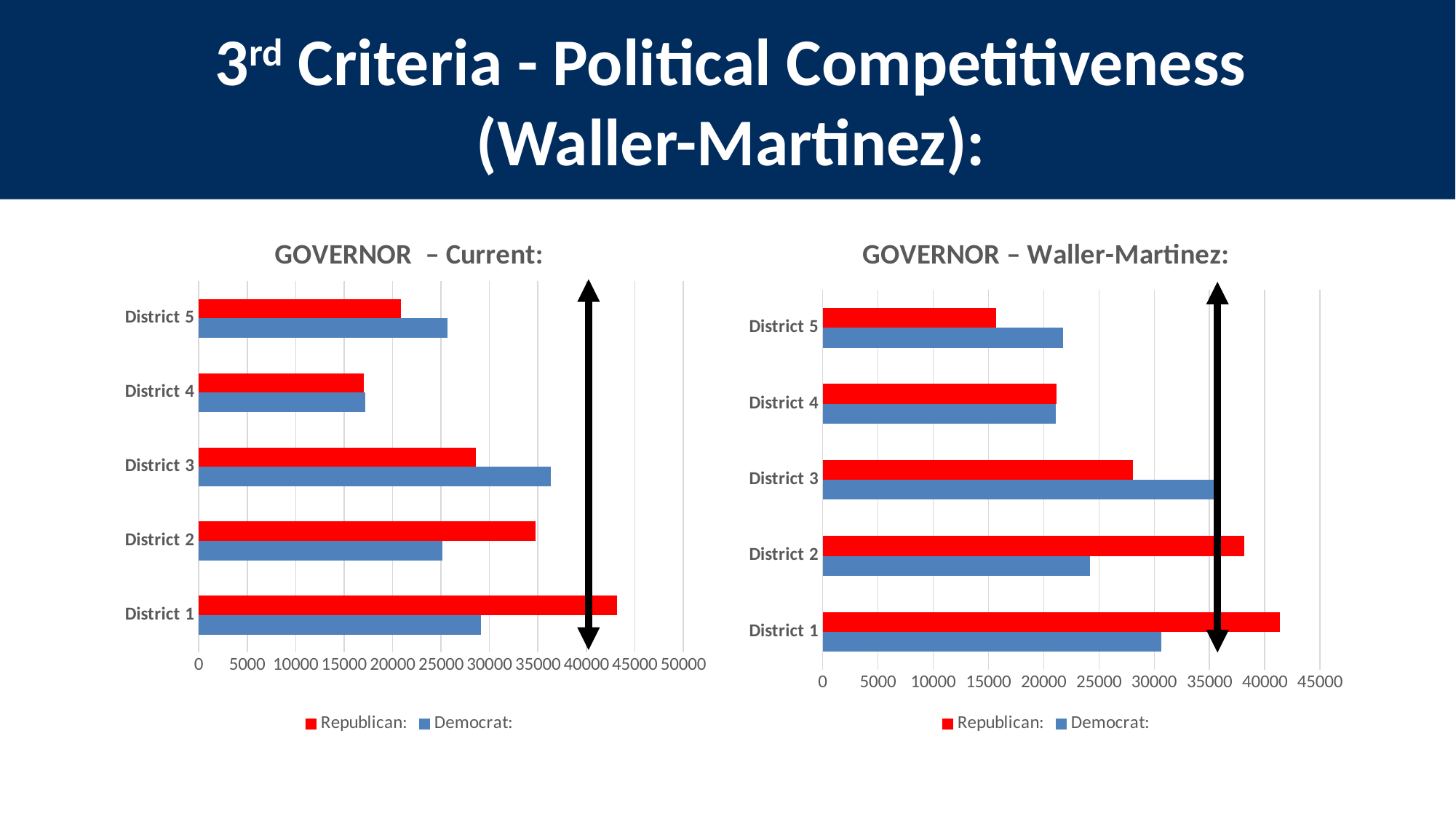
In the 'GOVERNOR – Current:' chart, which district has the lowest Republican value? District 4 In the 'GOVERNOR – Current:' chart, which district has the highest Democrat value? District 3 In the 'GOVERNOR – Current:' chart, how many districts are shown? 5 In the 'GOVERNOR – Waller-Martinez:' chart, which district has the lowest Republican value? District 5 In the 'GOVERNOR – Current:' chart, is the Republican value for District 1 greater or less than 40000? greater In the 'GOVERNOR – Waller-Martinez:' chart, how many series does the legend list? 2 In the 'GOVERNOR – Waller-Martinez:' chart, is the Democrat value for District 3 greater or less than 30000? greater In the 'GOVERNOR – Current:' chart, which is larger for District 2, the Republican or the Democrat value? Republican What type of chart is the 'GOVERNOR – Current:' chart? bar chart In the 'GOVERNOR – Waller-Martinez:' chart, which district has the highest Republican value? District 1 In the 'GOVERNOR – Current:' chart, which district has the highest Republican value? District 1 In the 'GOVERNOR – Waller-Martinez:' chart, which is larger for District 5, the Republican or the Democrat value? Democrat